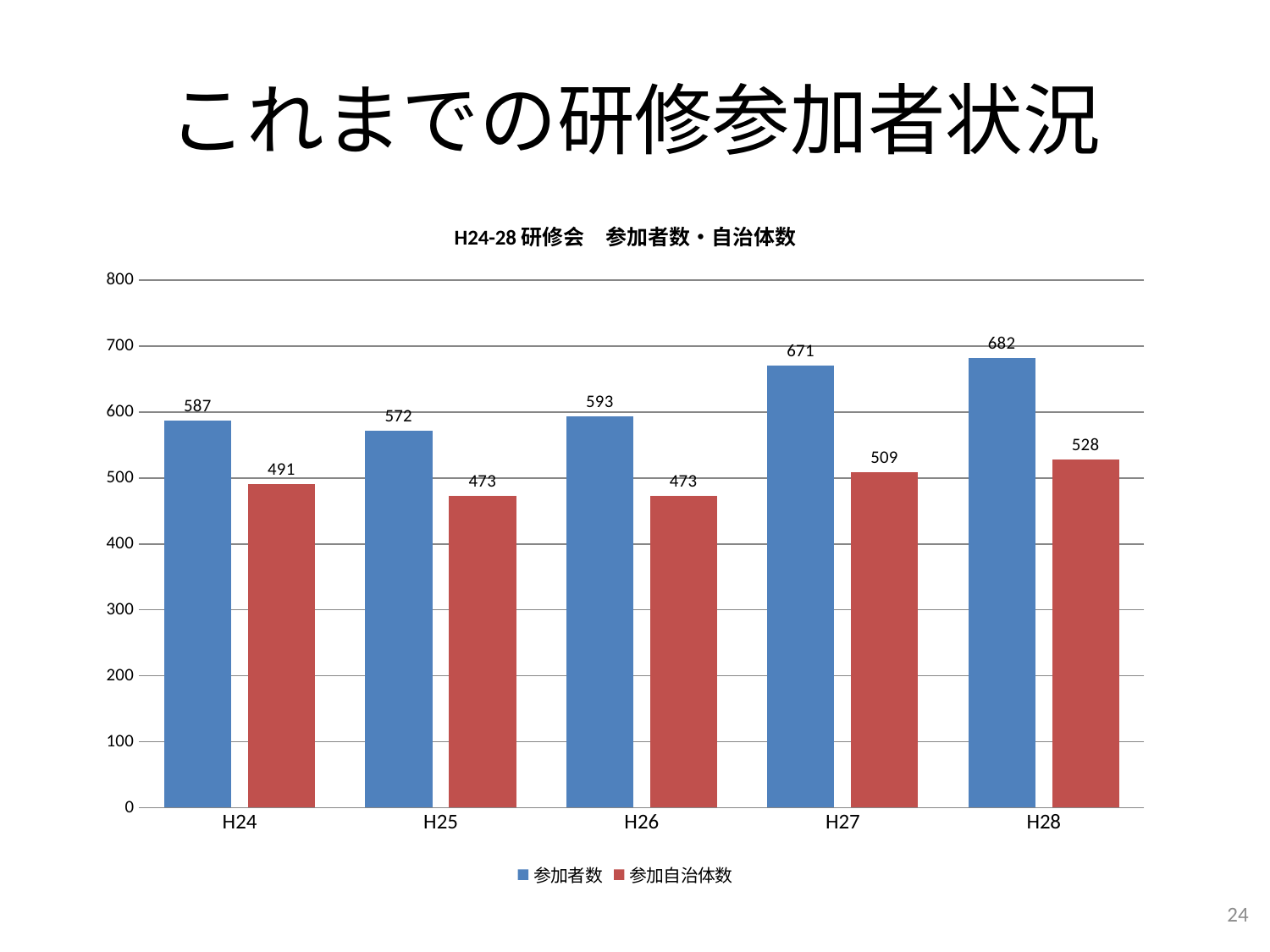
Which is larger, 参加自治体数 for H24 or for H25? H24 How many series does the legend list? 2 Which year has the lowest 参加者数? H25 What is the difference in 参加者数 between H27 and H26? 78 What is the value of 参加者数 for H24? 587 What is the value of 参加自治体数 for H27? 509 What is the difference between 参加者数 and 参加自治体数 in H28? 154 What kind of chart is shown on the slide? Bar chart Is the value of 参加者数 for H27 greater or less than 600? greater Which year has the highest 参加者数? H28 Which year has the highest 参加自治体数? H28 How many years are shown on the x axis? 5